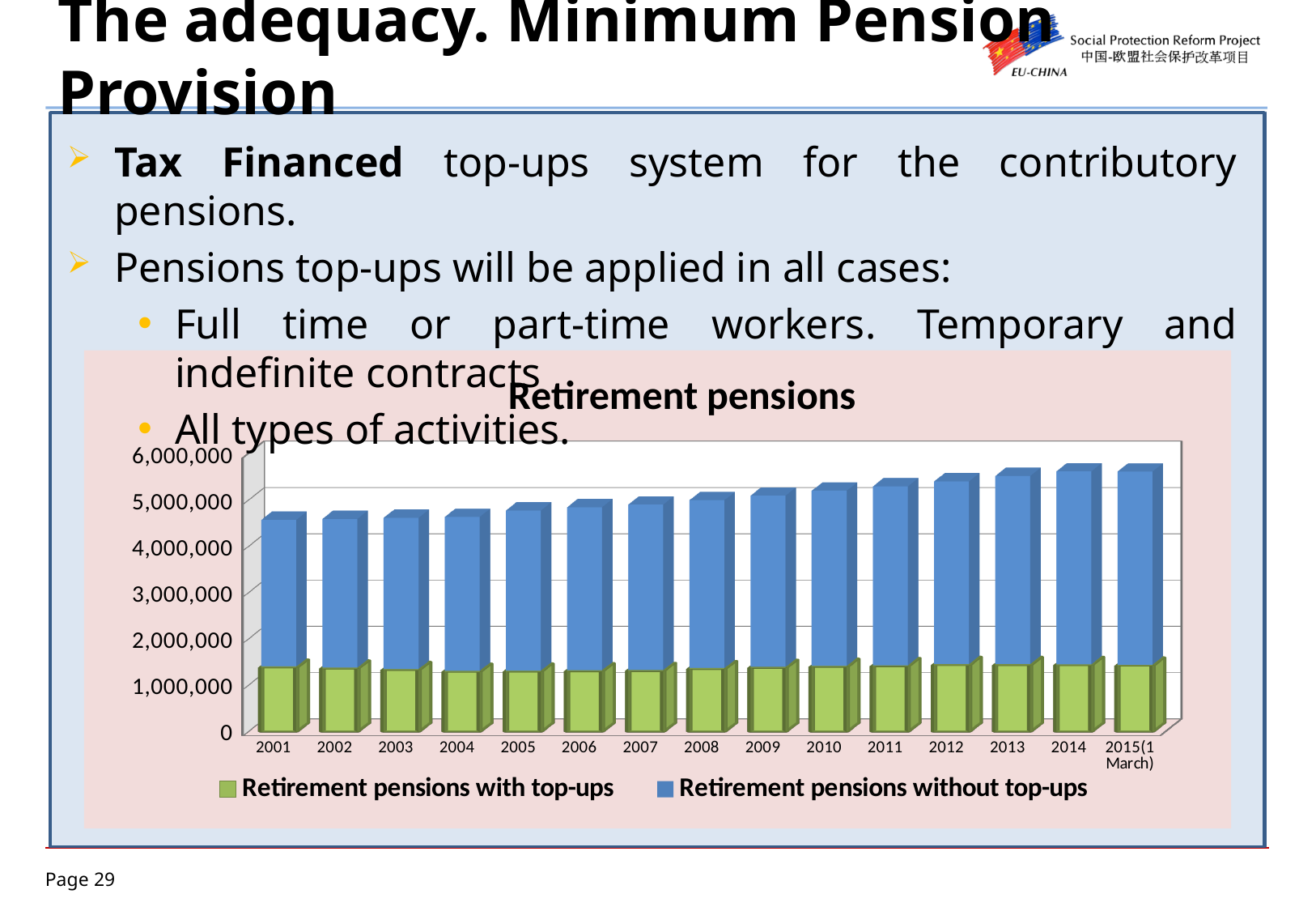
Is the value for Retirement pensions with top-ups in 2005 greater or less than 2,000,000? less How many series does the chart legend list? 2 Does the total height of the stacked bars rise or fall from 2001 to 2014? Rise Which year has the larger total stacked value: 2001 or 2014? 2014 How many years (categories) are shown on the x axis of the chart? 15 What is the title of the chart? Retirement pensions Is the total stacked value for 2001 greater or less than 4,000,000? greater What kind of chart is shown on the slide? Stacked bar chart Which is larger in 2010: Retirement pensions with top-ups or Retirement pensions without top-ups? Retirement pensions without top-ups Is the total stacked value for 2014 greater or less than 5,000,000? greater Which series is shown in green in the chart? Retirement pensions with top-ups